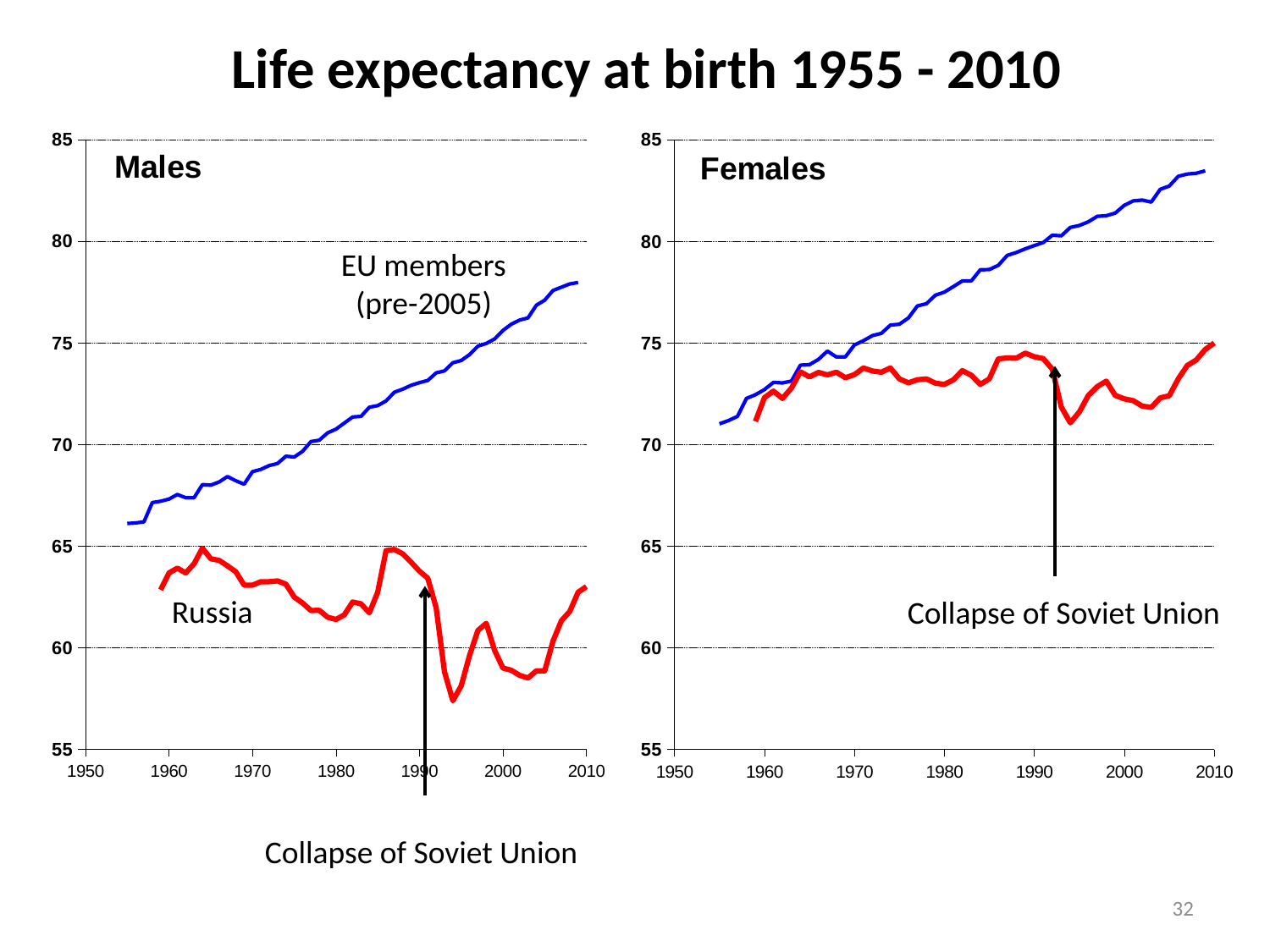
What event do the arrows in both charts mark? Collapse of Soviet Union How many series are plotted in the Females chart? 2 In the Males chart, does the Russia line rise or fall in the years immediately after the collapse of the Soviet Union? falls In the Females chart, which series is higher in 2005, EU members (pre-2005) or Russia? EU members (pre-2005) In the Males chart, does the EU members (pre-2005) line rise or fall from 1955 to 2010? rises In the Males chart, which series has the higher life expectancy in 2000, EU members (pre-2005) or Russia? EU members (pre-2005) In the Females chart, is the EU members (pre-2005) value in 2010 greater or less than 80? greater What is the title of the slide? Life expectancy at birth 1955 - 2010 In the Males chart, is the Russia value around 1994 greater or less than 60? less In the Females chart, is the Russia value in 1980 greater or less than 75? less What kind of chart is the Males chart on the left? Line chart